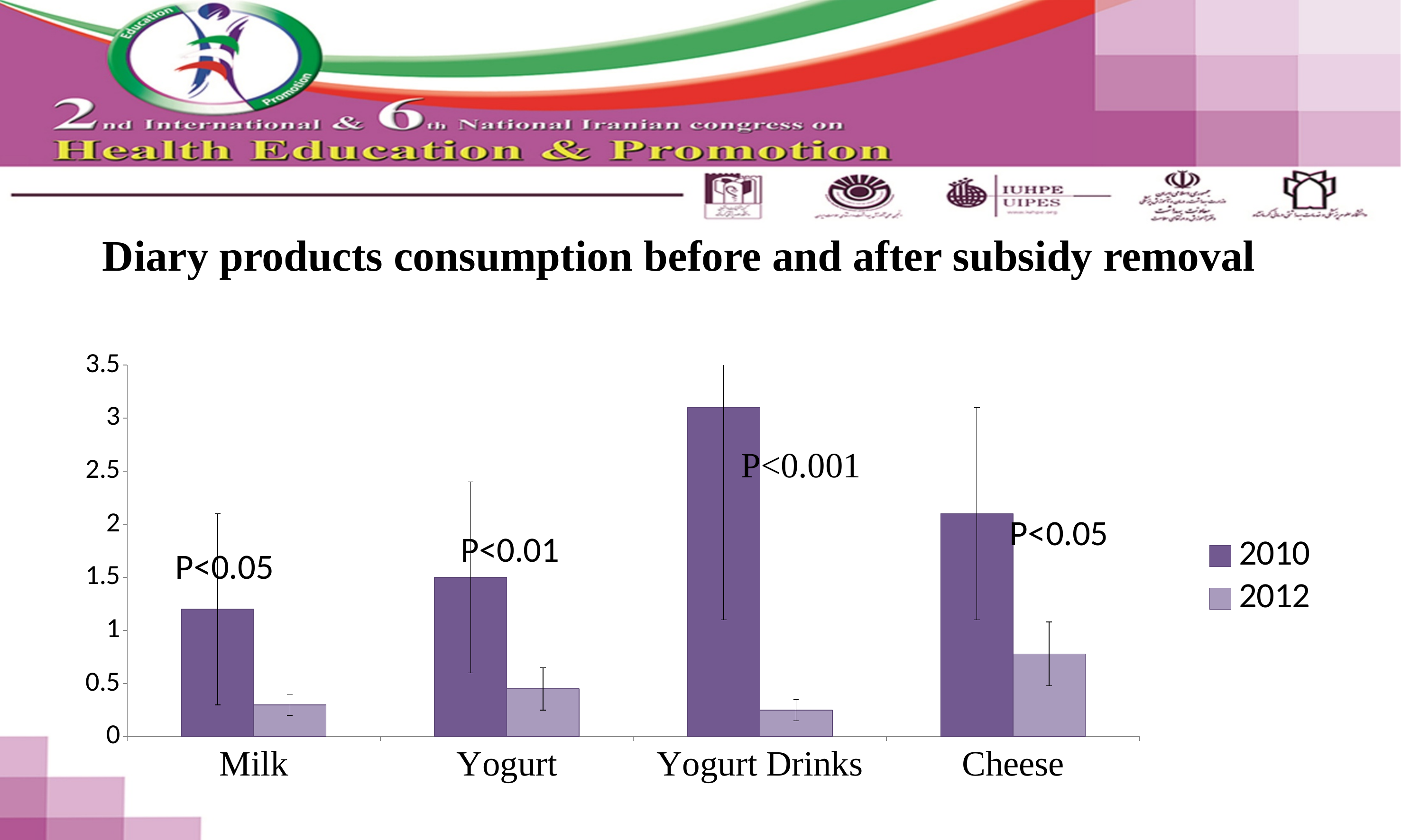
Is the 2012 value for Cheese greater or less than 1? less How many product categories are shown on the x axis? 4 What kind of chart is shown on the slide? bar chart How many series does the legend list? 2 Which product has the highest 2012 value? Cheese What p-value annotation is shown next to the Yogurt Drinks bars? P<0.001 For Milk, which year has the larger value, 2010 or 2012? 2010 What is the title of the chart? Diary products consumption before and after subsidy removal Which product has the lowest 2010 value? Milk Which product has the highest 2010 value? Yogurt Drinks